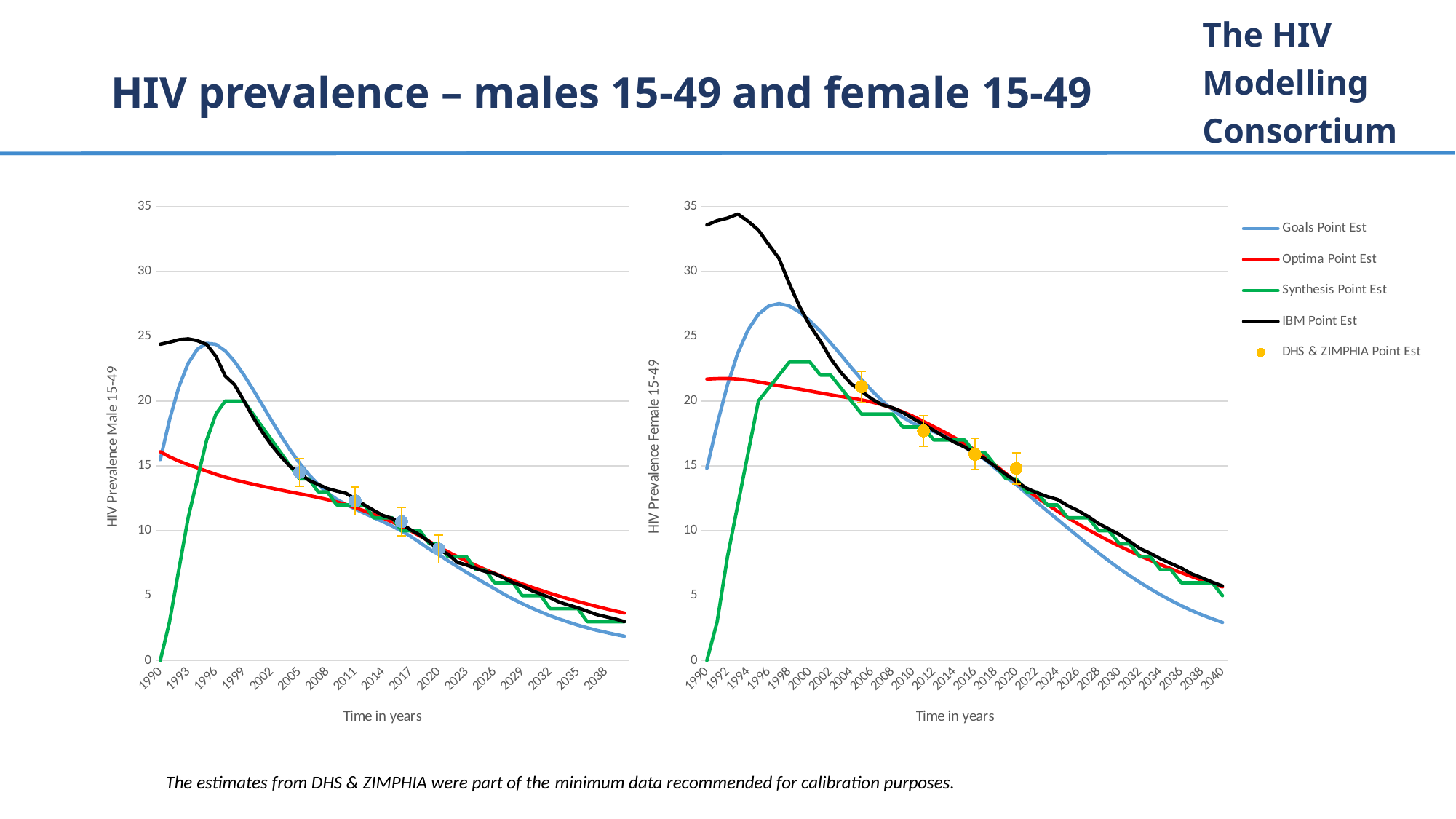
In the right chart (HIV Prevalence Female 15-49), does the Optima Point Est line rise or fall from 1990 to 2040? fall Which legend entry is shown as yellow dots rather than a line? DHS & ZIMPHIA Point Est What kind of chart is the left chart (HIV Prevalence Male 15-49)? line chart In the right chart (HIV Prevalence Female 15-49), is the peak of the Goals Point Est line greater or less than 25? greater In the right chart (HIV Prevalence Female 15-49), is the IBM Point Est value in 1990 greater or less than 30? greater In the left chart (HIV Prevalence Male 15-49), does the Goals Point Est line rise or fall from 2005 to 2038? fall In the left chart (HIV Prevalence Male 15-49), which series has the lowest value in 1990? Synthesis Point Est What is the x-axis title of both charts? Time in years How many entries does the legend list? 5 In the left chart (HIV Prevalence Male 15-49), is the Goals Point Est value in 2038 greater or less than 5? less In the right chart (HIV Prevalence Female 15-49), which line is higher in 1990: IBM Point Est or Goals Point Est? IBM Point Est